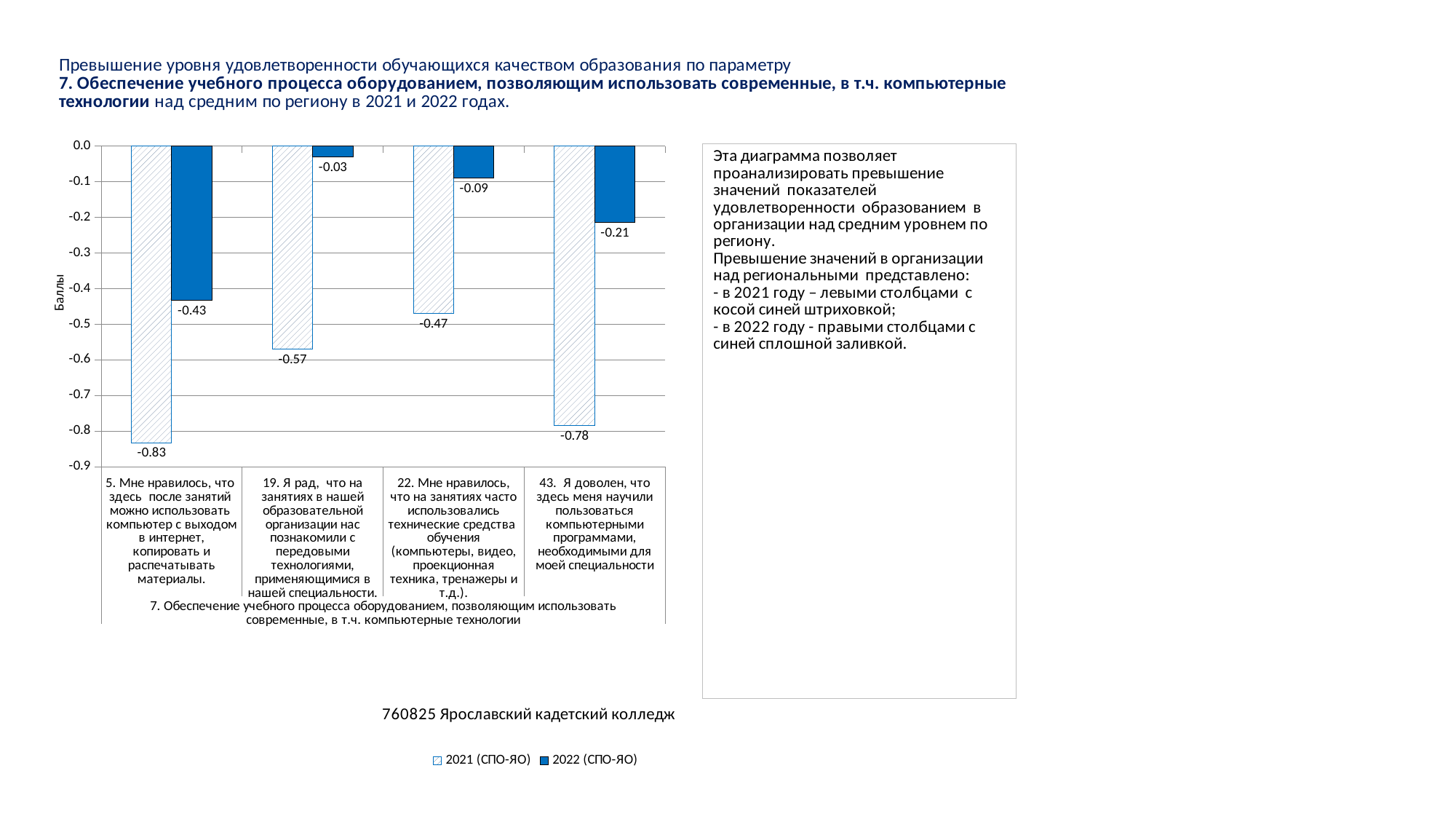
What is the 2022 (СПО-ЯО) value for item 43 ("Я доволен, что здесь меня научили пользоваться компьютерными программами...")? -0.21 Which item has the highest 2022 (СПО-ЯО) value? 19. Я рад, что на занятиях в нашей образовательной организации нас познакомили с передовыми технологиями, применяющимися в нашей специальности. Which item has the lowest 2021 (СПО-ЯО) value? 5. Мне нравилось, что здесь после занятий можно использовать компьютер с выходом в интернет, копировать и распечатывать материалы. What is the 2022 (СПО-ЯО) value for item 19 ("Я рад, что на занятиях в нашей образовательной организации нас познакомили с передовыми технологиями...")? -0.03 How many series does the legend list? 2 What is the label of the vertical axis? Баллы Which is larger for item 43: the 2021 (СПО-ЯО) value or the 2022 (СПО-ЯО) value? 2022 (СПО-ЯО) What is the 2021 (СПО-ЯО) value for item 22 ("Мне нравилось, что на занятиях часто использовались технические средства обучения...")? -0.47 What kind of chart is shown on the slide? Bar chart What is the difference between the 2021 and 2022 values for item 5? 0.40 How many items (categories) are shown on the x axis? 4 What is the 2021 (СПО-ЯО) value for item 5 ("Мне нравилось, что здесь после занятий можно использовать компьютер...")? -0.83